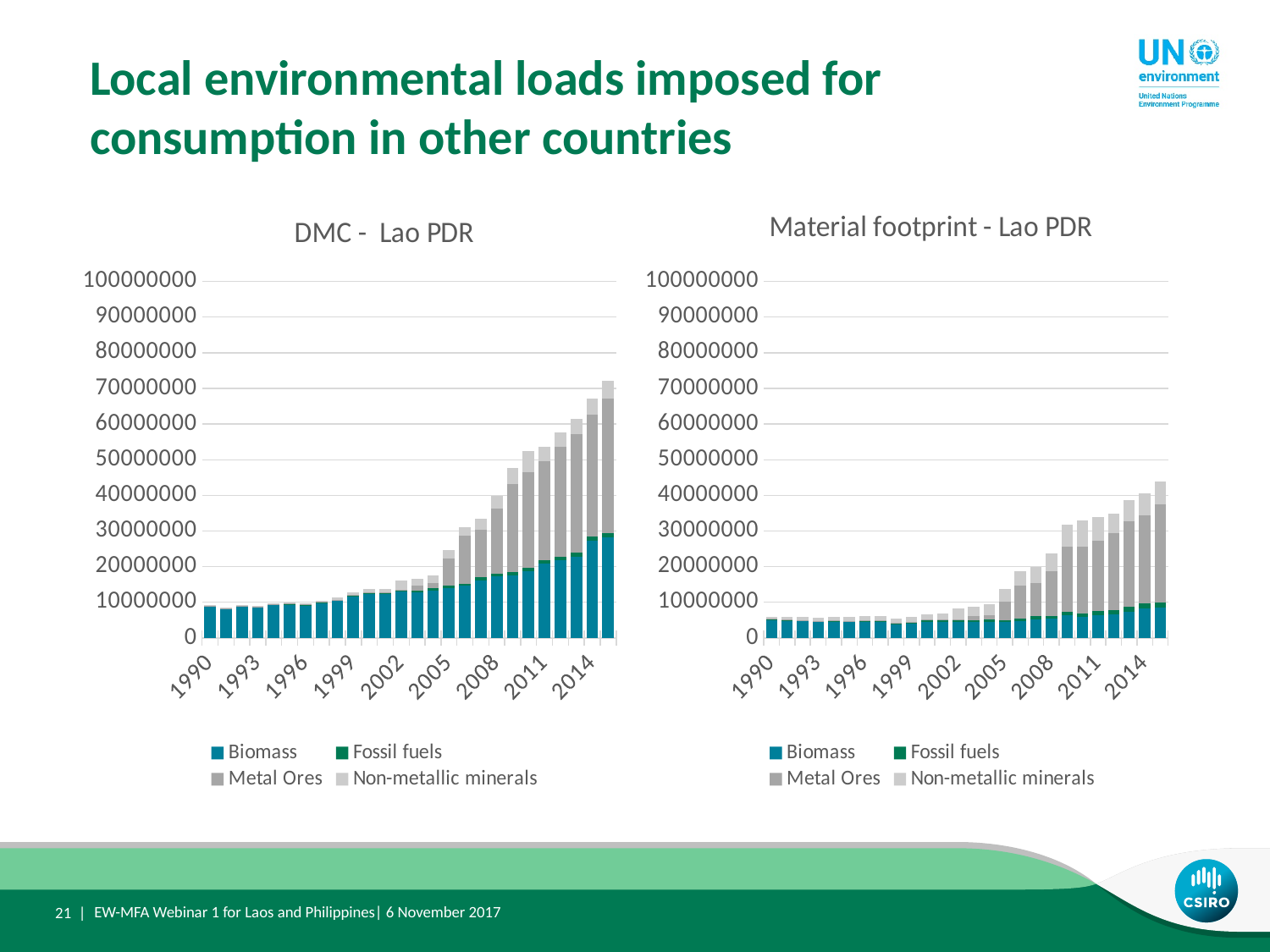
Which is larger for 2014: the total in the 'DMC - Lao PDR' chart or the total in the 'Material footprint - Lao PDR' chart? DMC - Lao PDR How many series does the legend of the 'Material footprint - Lao PDR' chart list? 4 What kind of chart is the 'DMC - Lao PDR' chart? Stacked bar chart In the 'Material footprint - Lao PDR' chart, do the total values rise or fall from 1990 to 2014? Rise In the 'DMC - Lao PDR' chart, is the total stacked value for 2014 greater or less than 50000000? greater In the 'Material footprint - Lao PDR' chart, is the total stacked value for 1990 greater or less than 10000000? less In the 'DMC - Lao PDR' chart, do the total values rise or fall from 1990 to 2014? Rise What is the title of the chart on the right side of the slide? Material footprint - Lao PDR Which series are listed in the legend of the 'DMC - Lao PDR' chart? Biomass, Fossil fuels, Metal Ores, Non-metallic minerals In the 'Material footprint - Lao PDR' chart, is the total stacked value for 2014 greater or less than 30000000? greater